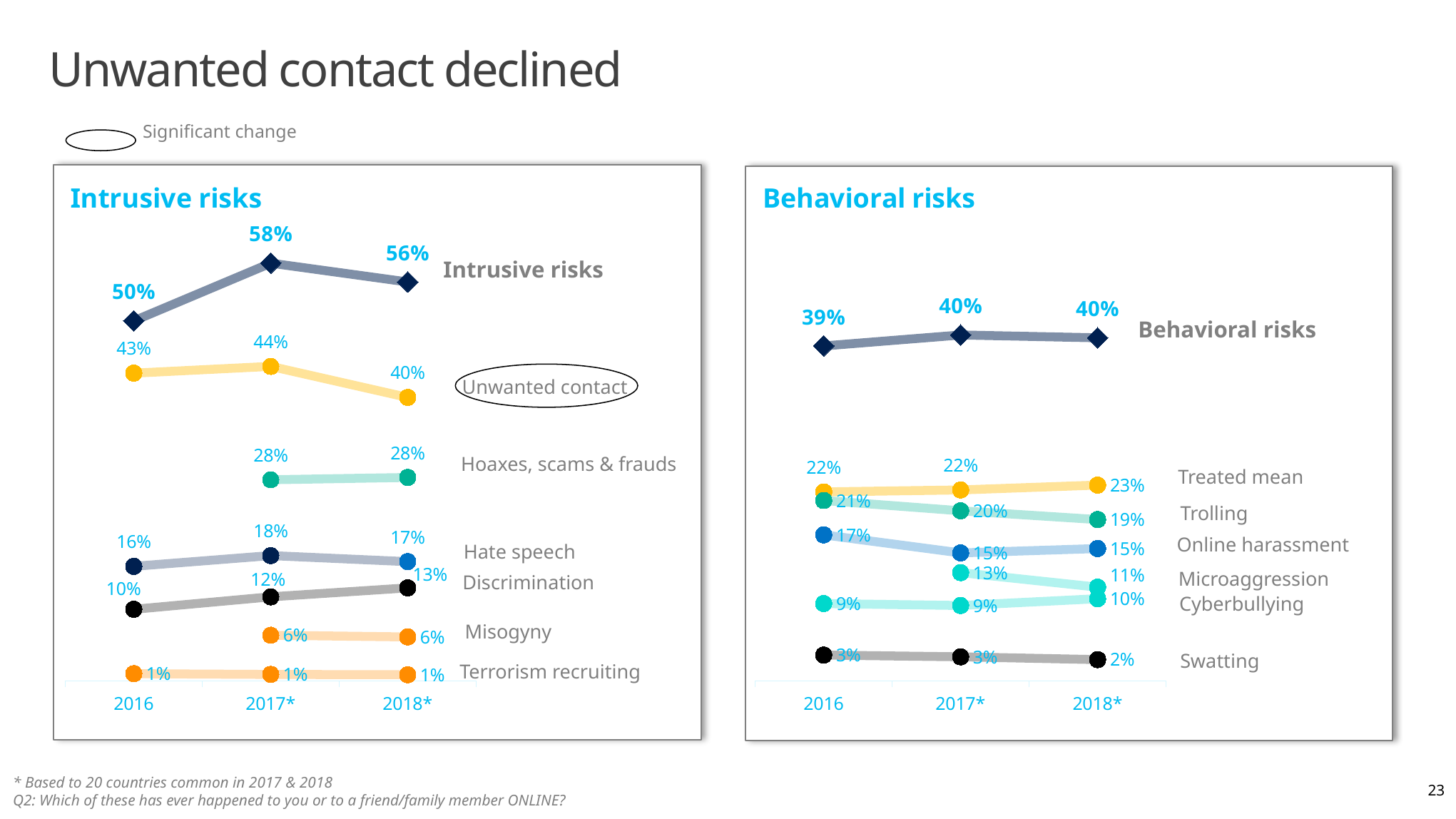
What kind of chart is the Behavioral risks chart? line chart In the Intrusive risks chart, what is the value for Discrimination in 2016? 10% How many years are shown on the x axis of the Behavioral risks chart? 3 In the Intrusive risks chart, does Hate speech rise or fall from 2017* to 2018*? fall In the Behavioral risks chart, what is the value for Trolling in 2018*? 19% In the Behavioral risks chart, which is larger in 2018*: Treated mean or Trolling? Treated mean In the Intrusive risks chart, what is the value for Unwanted contact in 2018*? 40% In the Intrusive risks chart, what is the value for Intrusive risks in 2017*? 58% In the Behavioral risks chart, what is the value for Online harassment in 2016? 17% In the Intrusive risks chart, which series has the lowest values across all years? Terrorism recruiting In the Behavioral risks chart, what is the difference between Behavioral risks in 2016 and 2017*? 1 percentage point In the Intrusive risks chart, by how much did Unwanted contact change from 2017* to 2018*? 4 percentage points